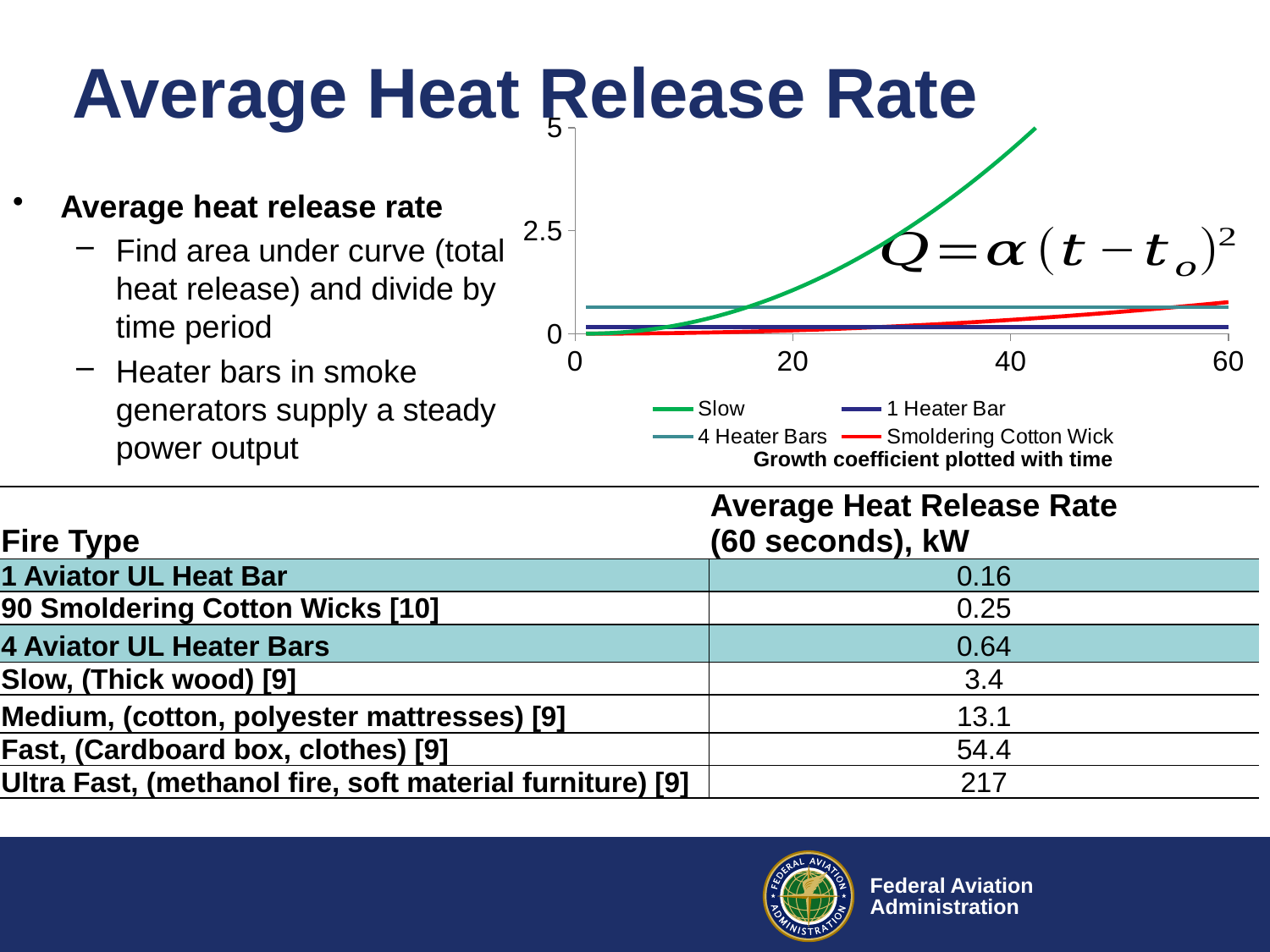
Does the Slow series rise or fall as time increases along the x axis? Rises Which series in the chart reaches the highest value? Slow At time 60, which series has the larger value, Smoldering Cotton Wick or 1 Heater Bar? Smoldering Cotton Wick Is the value of the 4 Heater Bars series greater or less than 2.5? less How many series does the chart's legend list? 4 What is the highest tick value shown on the chart's x axis? 60 At time 40, which series has the larger value, Slow or 4 Heater Bars? Slow What kind of chart is shown on the slide? Line chart Is the value of the Slow series at time 40 greater or less than 2.5? greater Is the value of the Slow series at time 20 greater or less than 2.5? less What caption appears below the chart's legend? Growth coefficient plotted with time